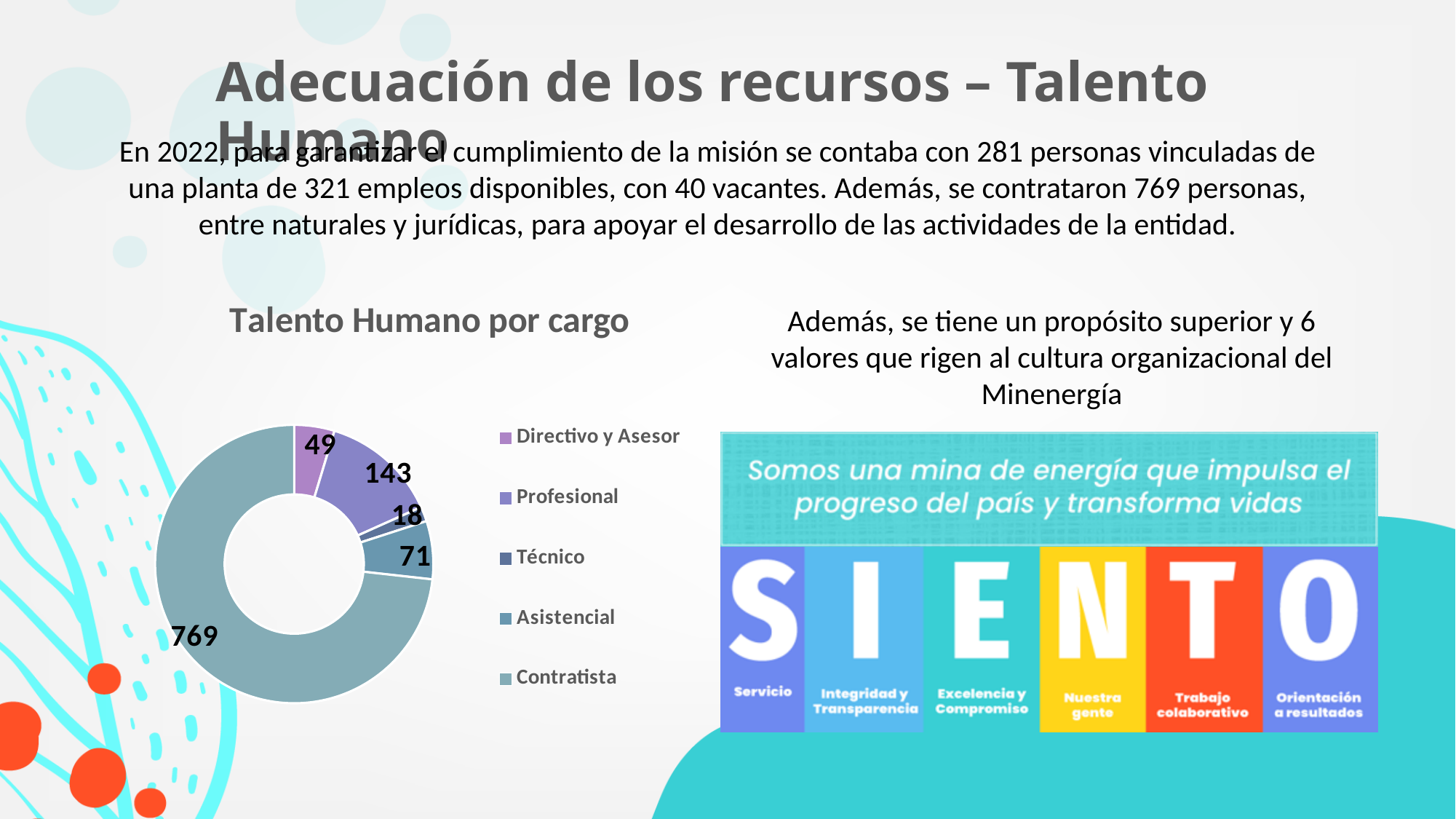
In the 'Talento Humano por cargo' chart, what is the value for Profesional? 143 In the 'Talento Humano por cargo' chart, what is the value for Asistencial? 71 In the 'Talento Humano por cargo' chart, which is larger: Directivo y Asesor or Asistencial? Asistencial What kind of chart is 'Talento Humano por cargo'? Donut (pie) chart In the 'Talento Humano por cargo' chart, what is the difference between Profesional and Asistencial? 72 How many categories does the 'Talento Humano por cargo' chart show? 5 What is the total of all categories in the 'Talento Humano por cargo' chart? 1050 Which category has the smallest value in the 'Talento Humano por cargo' chart? Técnico In the 'Talento Humano por cargo' chart, what is the value for Contratista? 769 In the 'Talento Humano por cargo' chart, what is the value for Directivo y Asesor? 49 Which category has the largest value in the 'Talento Humano por cargo' chart? Contratista In the 'Talento Humano por cargo' chart, what is the value for Técnico? 18